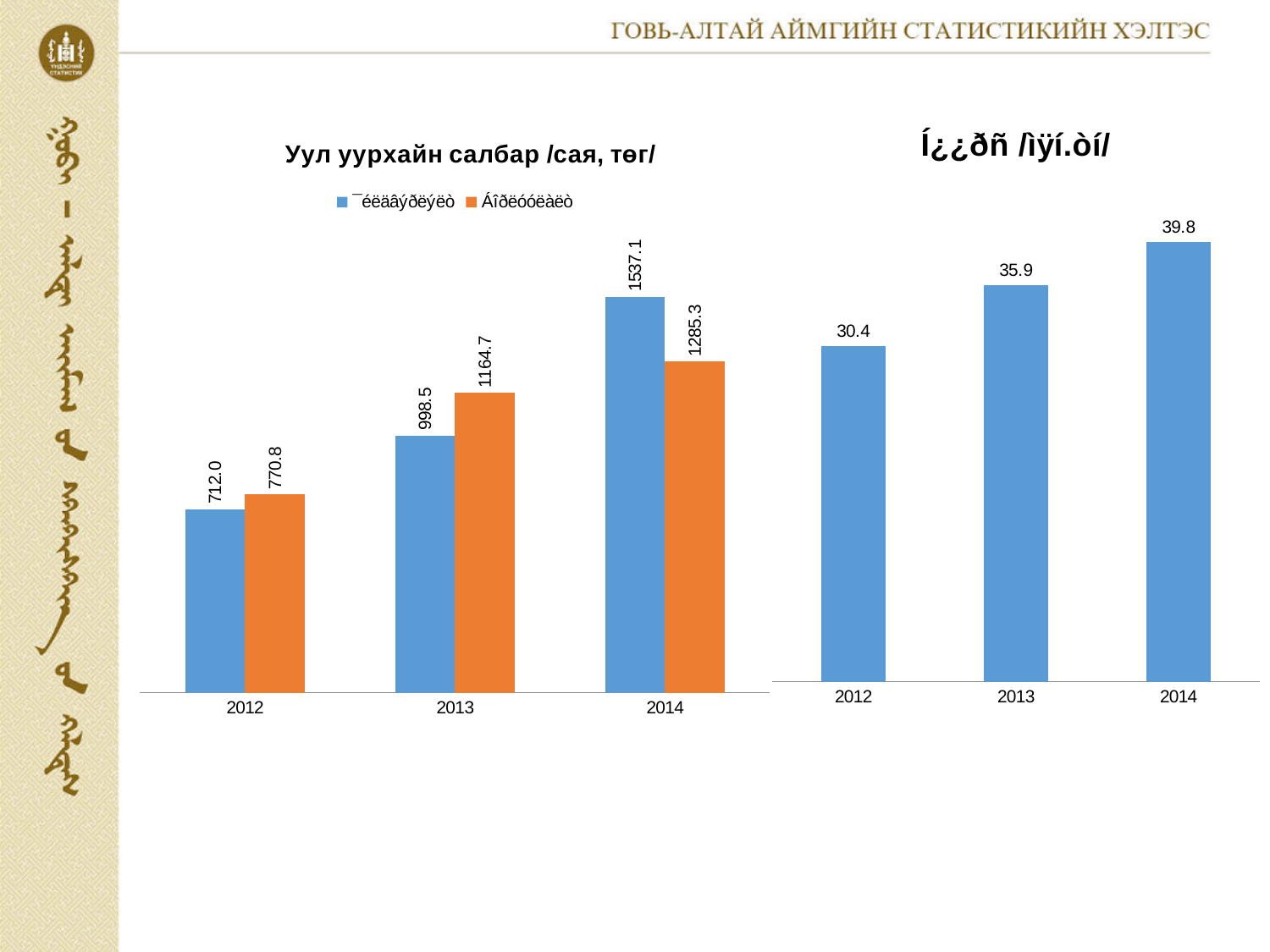
In the chart on the right of the slide, what is the value for 2013? 35.9 In the chart titled "Уул уурхайн салбар /сая, төг/", which year has the highest blue bar? 2014 In the chart titled "Уул уурхайн салбар /сая, төг/", what is the difference between the blue and orange bars for 2014? 251.8 How many years are shown on the x axis of the chart titled "Уул уурхайн салбар /сая, төг/"? 3 How many series does the legend of the chart titled "Уул уурхайн салбар /сая, төг/" list? 2 In the chart titled "Уул уурхайн салбар /сая, төг/", what is the value of the blue bar for 2014? 1537.1 In the chart titled "Уул уурхайн салбар /сая, төг/", what is the value of the orange bar for 2013? 1164.7 In the chart on the right of the slide, what is the difference between the values for 2014 and 2012? 9.4 In the chart on the right of the slide, do the values rise or fall from 2012 to 2014? Rise In the chart titled "Уул уурхайн салбар /сая, төг/", what is the value of the orange bar for 2012? 770.8 In the chart on the right of the slide, which year has the lowest value? 2012 In the chart titled "Уул уурхайн салбар /сая, төг/", which is larger for 2013, the blue bar or the orange bar? The orange bar